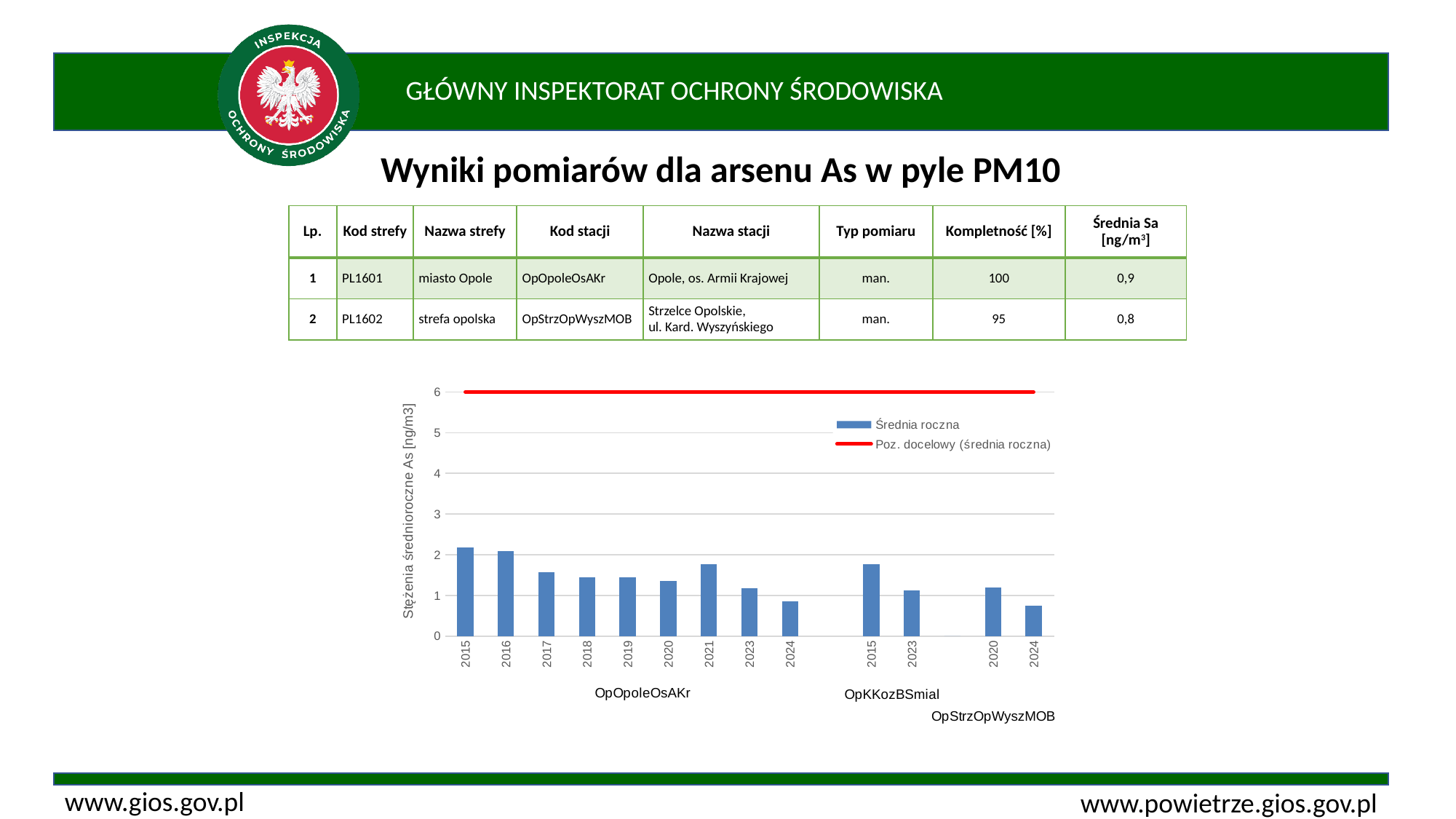
What kind of chart is shown on the slide? bar chart Is the value for OpStrzOpWyszMOB in 2024 greater or less than 1? less At what value on the y axis does the red 'Poz. docelowy (średnia roczna)' line sit? 6 How many bars are plotted for the station OpOpoleOsAKr? 9 What is the label of the chart's y axis? Stężenia średnioroczne As [ng/m3] Which is larger for OpOpoleOsAKr: the value in 2015 or the value in 2024? 2015 Is the value for OpKKozBSmial in 2015 greater or less than 1? greater Is the value for OpOpoleOsAKr in 2015 greater or less than 2? greater How many bars are plotted in total across all stations in the chart? 13 How many series does the chart legend list? 2 Do the values for OpOpoleOsAKr generally rise or fall from 2015 to 2024? fall